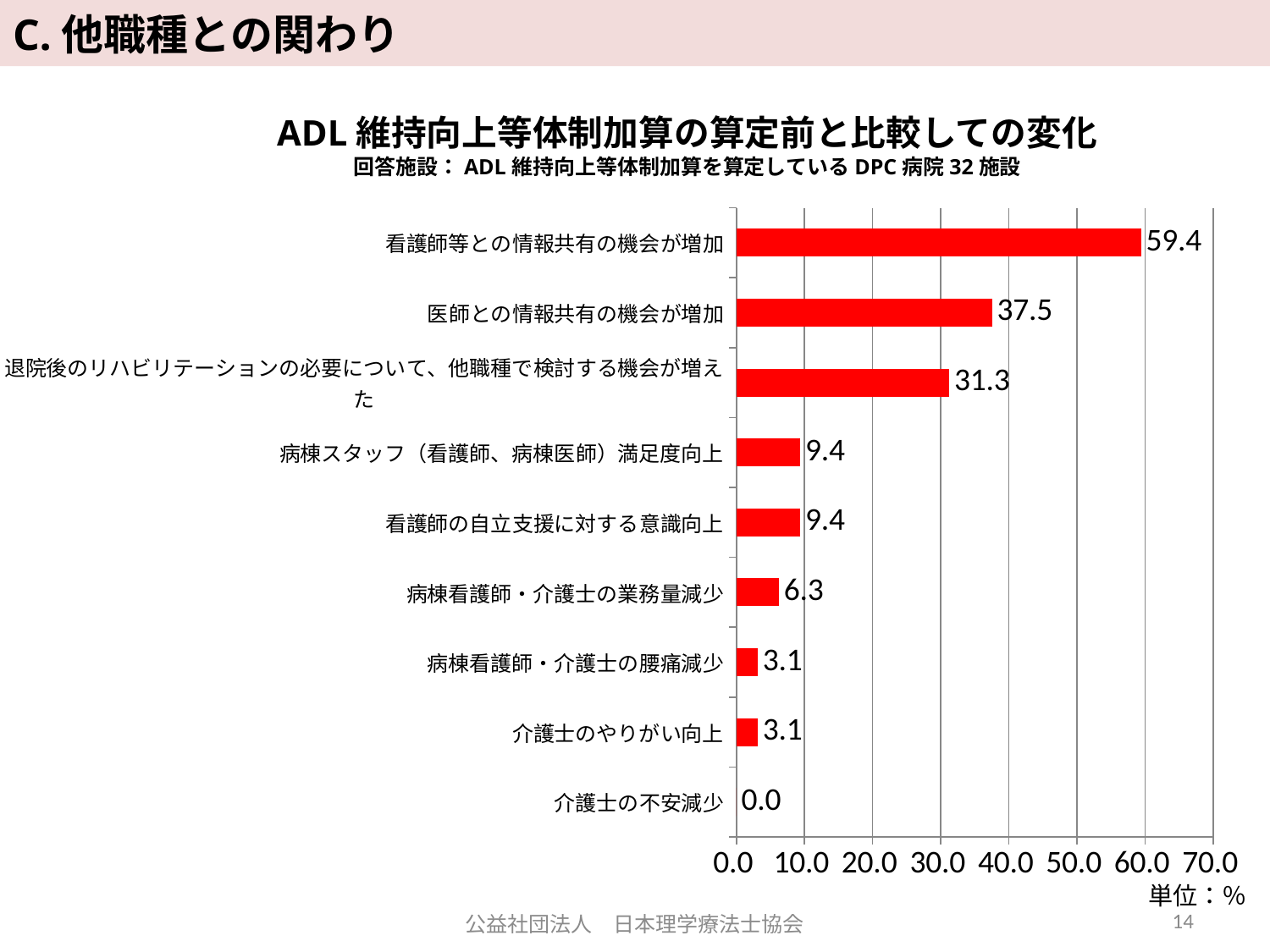
What kind of chart is shown on the slide? bar chart Which is larger: the value for 医師との情報共有の機会が増加 or the value for 退院後のリハビリテーションの必要について、他職種で検討する機会が増えた? 医師との情報共有の機会が増加 What is the value for 介護士の不安減少? 0.0 Is the value for 退院後のリハビリテーションの必要について、他職種で検討する機会が増えた greater or less than 40.0? less What is the value for 看護師等との情報共有の機会が増加? 59.4 What is the difference between the values for 看護師等との情報共有の機会が増加 and 医師との情報共有の機会が増加? 21.9 Which category has the lowest value? 介護士の不安減少 Which category has the highest value? 看護師等との情報共有の機会が増加 What is the value for 医師との情報共有の機会が増加? 37.5 What is the value for 病棟看護師・介護士の業務量減少? 6.3 How many categories are shown in the chart? 9 What unit is indicated for the values in the chart? %